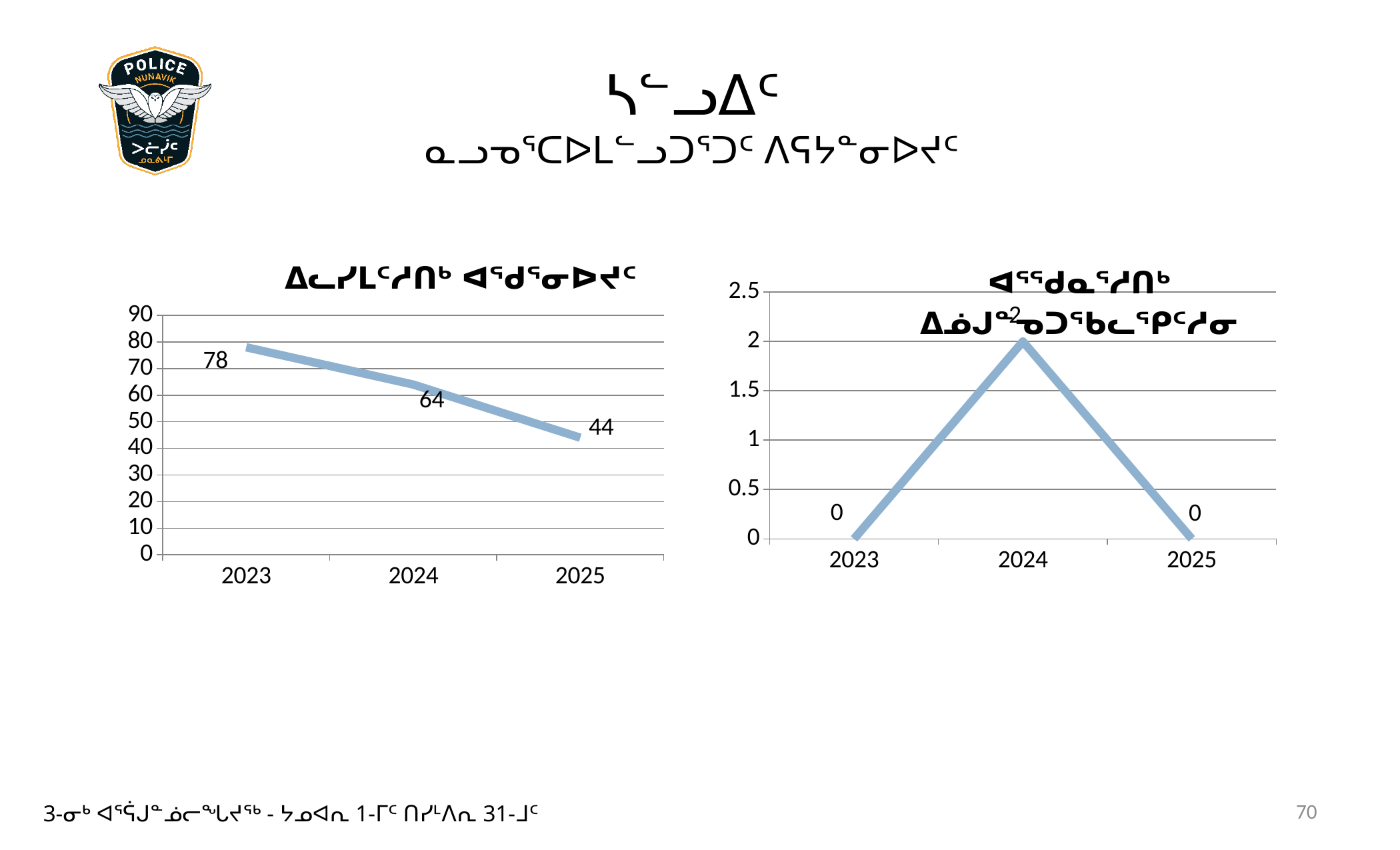
In the left chart, which year has the lowest value? 2025 In the left chart, what is the difference between the values for 2023 and 2024? 14 In the left chart, what is the value for 2023? 78 What kind of chart is the left chart? line chart In the right chart, what is the value for 2024? 2 In the right chart, which year has the highest value? 2024 How many years are shown on the x axis of the right chart? 3 In the left chart, which is larger, the value for 2023 or the value for 2025? 2023 In the left chart, what is the difference between the values for 2024 and 2025? 20 In the left chart, what is the value for 2025? 44 In the left chart, is the value for 2024 greater or less than 60? greater In the left chart, do the values rise or fall from 2023 to 2025? fall